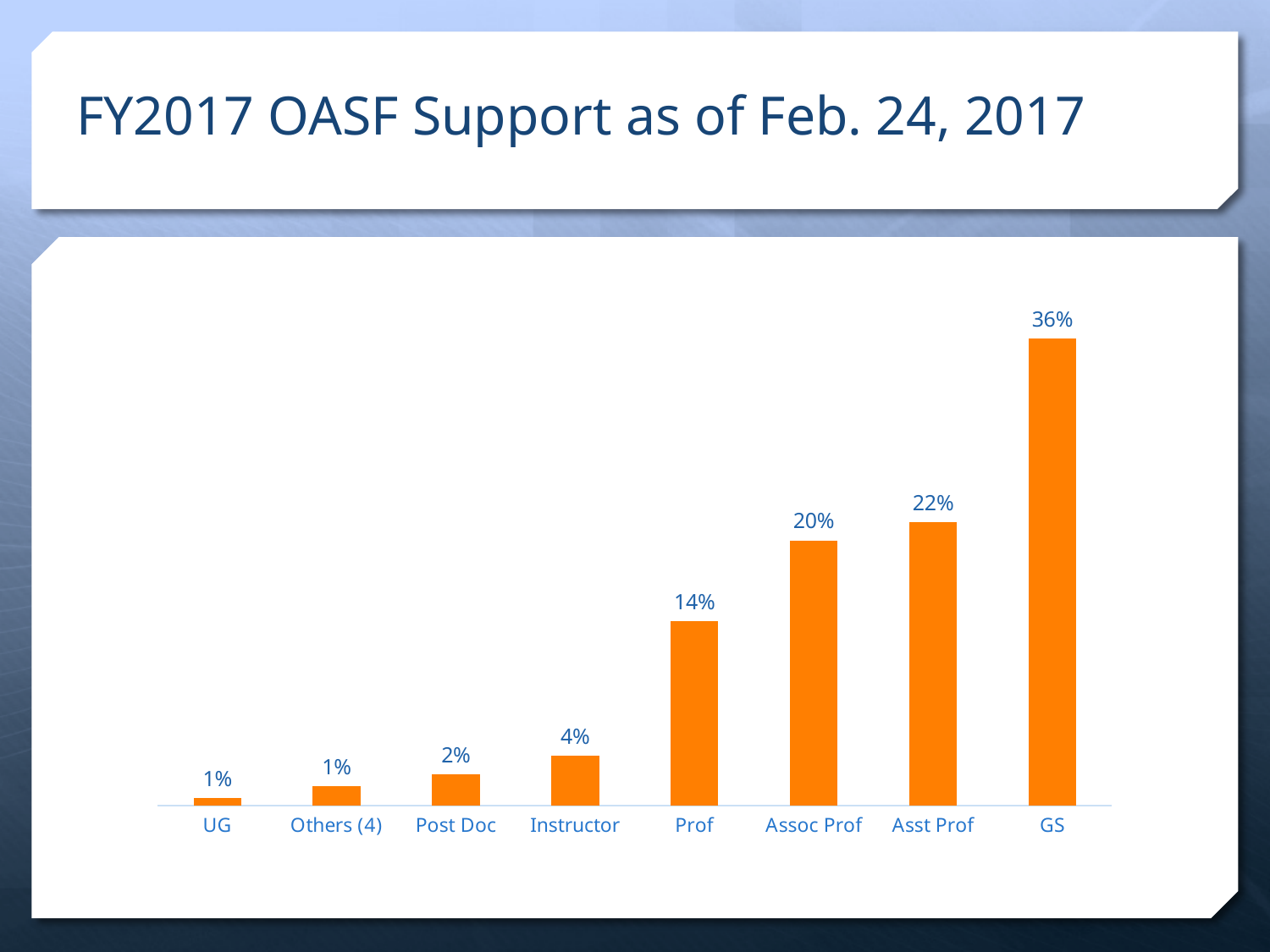
Which category has the highest value? GS What is the difference between the values for Assoc Prof and Prof? 6% What is the value for Post Doc? 2% Do the values rise or fall from left to right along the x axis? Rise What is the value for GS? 36% What is the value for Prof? 14% What is the title of the slide? FY2017 OASF Support as of Feb. 24, 2017 What kind of chart is shown on the slide? Bar chart How many categories are shown on the x axis? 8 Which is larger, the value for Instructor or the value for Post Doc? Instructor What is the difference between the values for GS and Asst Prof? 14% What is the value for Asst Prof? 22%